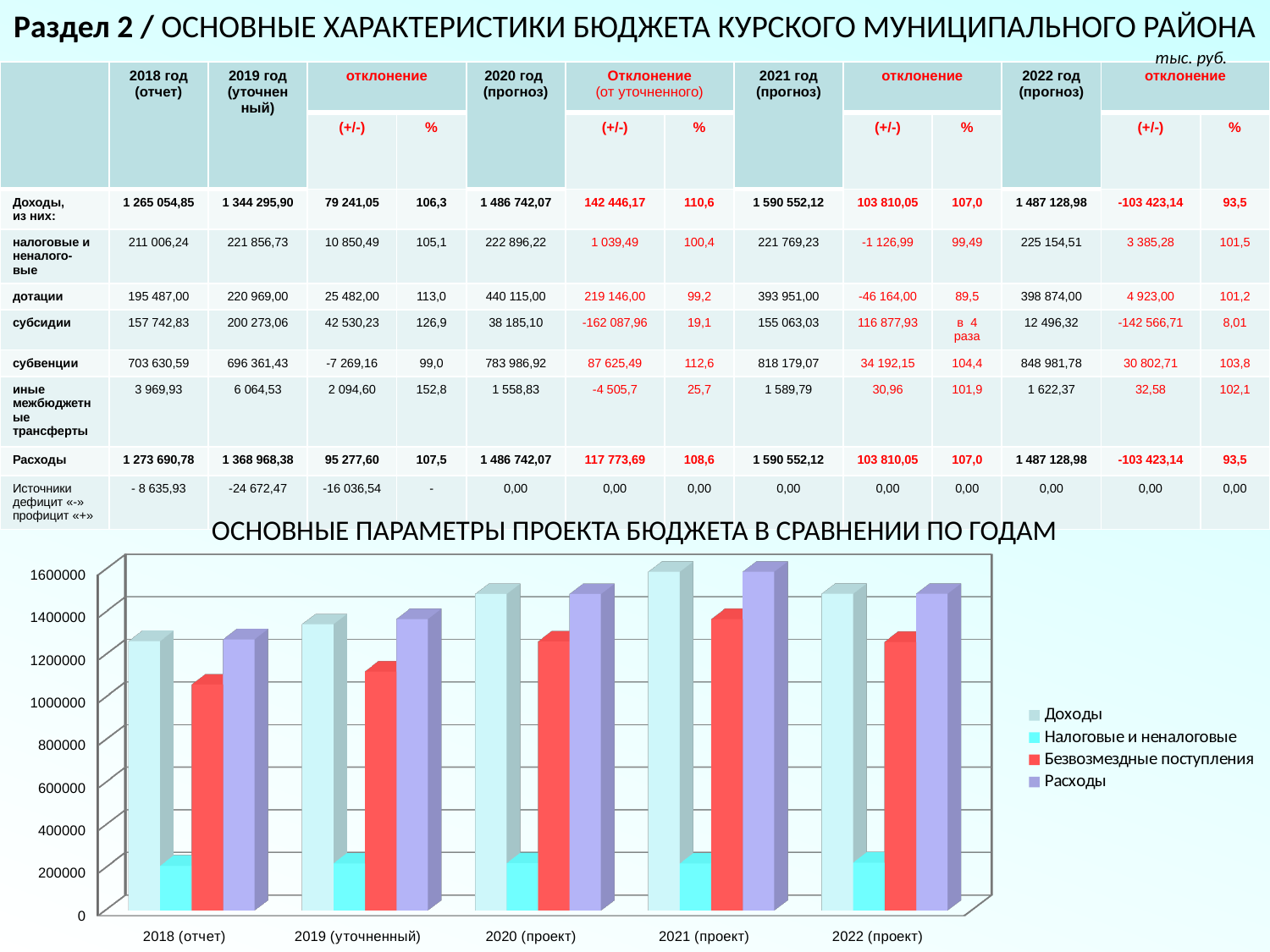
In which year category is the Доходы bar the lowest? 2018 (отчет) In which year category is the Безвозмездные поступления bar the highest? 2021 (проект) How many series does the legend of the chart list? 4 What kind of chart is shown below the table on the slide? bar chart How many year categories are shown on the x axis of the chart? 5 Which is larger in the chart: Доходы for 2020 (проект) or Доходы for 2019 (уточненный)? 2020 (проект) Is the value of Налоговые и неналоговые for 2018 (отчет) greater or less than 400000? less Which series in the chart is shown in red? Безвозмездные поступления Do the Доходы bars rise or fall from 2018 (отчет) to 2021 (проект)? rise What is the title of the chart? ОСНОВНЫЕ ПАРАМЕТРЫ ПРОЕКТА БЮДЖЕТА В СРАВНЕНИИ ПО ГОДАМ Is the value of Доходы for 2018 (отчет) greater or less than 1200000? greater In which year category is the Доходы bar the highest? 2021 (проект)